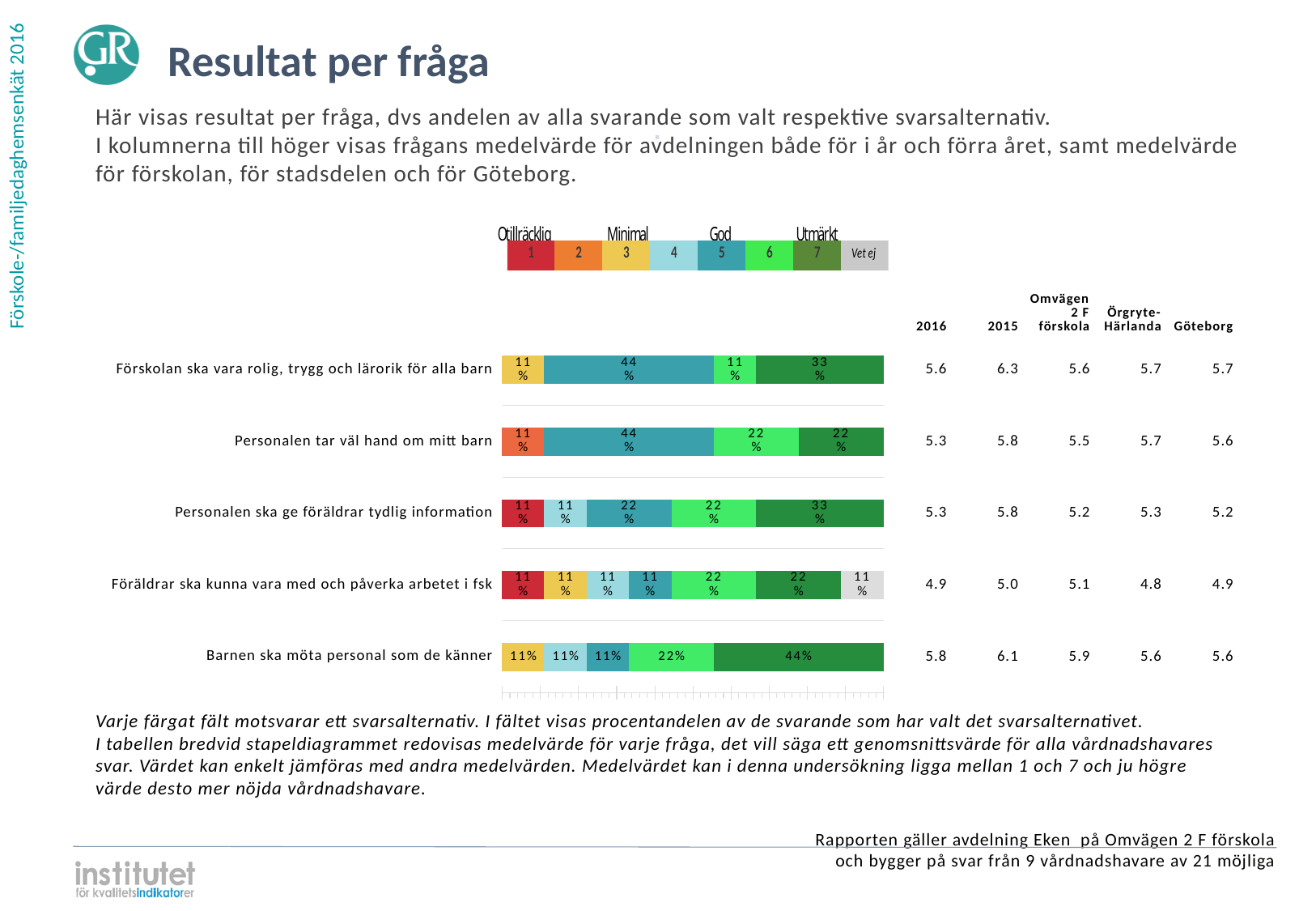
What percentage of respondents chose answer 5 (teal) for "Förskolan ska vara rolig, trygg och lärorik för alla barn"? 44% What is the difference between the share of answer 7 and the share of answer 6 for "Förskolan ska vara rolig, trygg och lärorik för alla barn"? 22% How many questions (bars) are plotted in the chart? 5 Which question has the largest share of answer 7 (dark green)? Barnen ska möta personal som de känner What percentage of respondents chose answer 1 (red) for "Personalen ska ge föräldrar tydlig information"? 11% Which question has the most segments (answer alternatives chosen) in its bar? Föräldrar ska kunna vara med och påverka arbetet i fsk What percentage of respondents chose answer 7 (Utmärkt, dark green) for "Barnen ska möta personal som de känner"? 44% What percentage of respondents answered "Vet ej" for "Föräldrar ska kunna vara med och påverka arbetet i fsk"? 11% What kind of chart is shown on the slide? Stacked bar chart What is the 2016 mean value shown for "Barnen ska möta personal som de känner"? 5.8 How many answer alternatives does the legend above the chart list? 8 For "Personalen tar väl hand om mitt barn", which is larger: the share of answer 5 or the share of answer 7? Answer 5